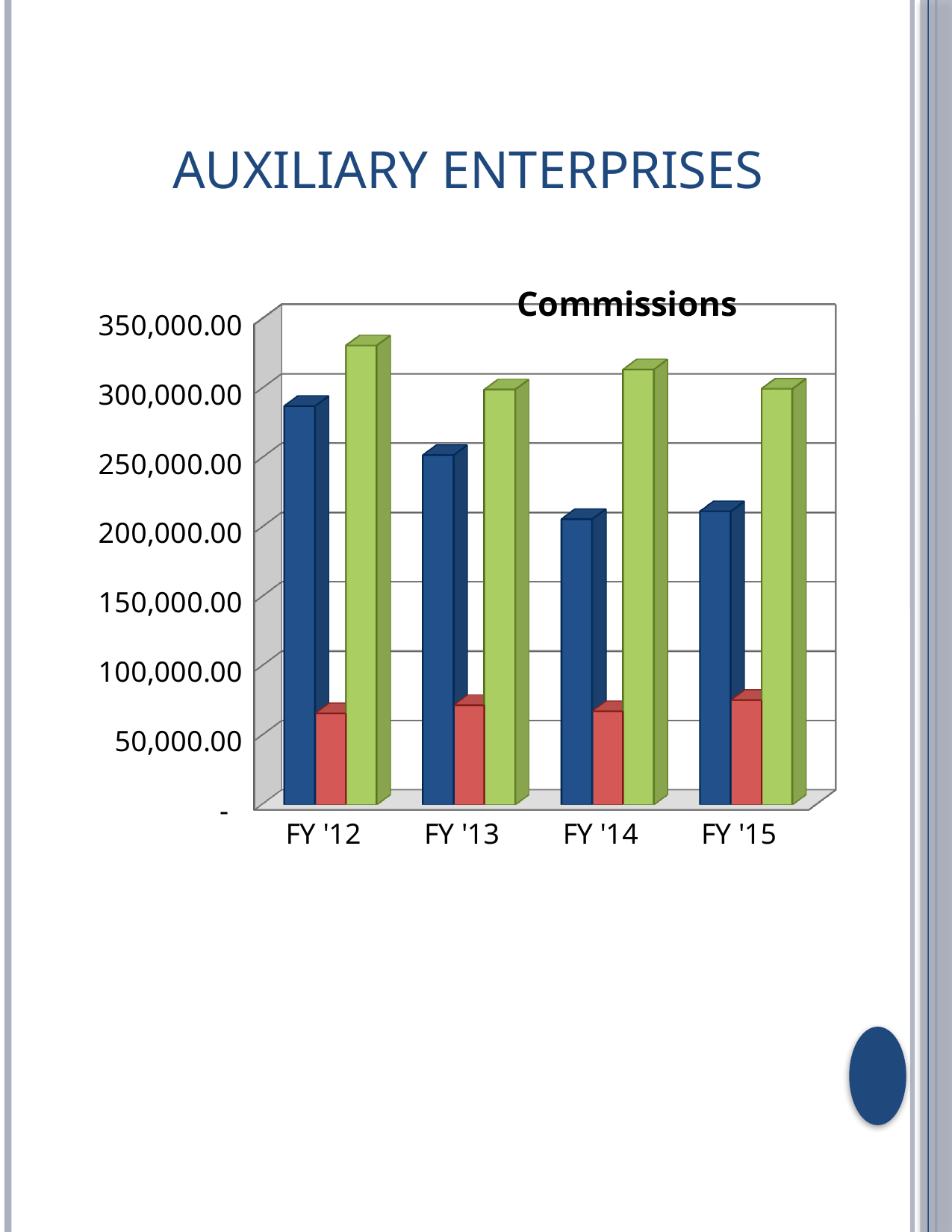
In which fiscal year is the green bar the highest? FY '12 How many fiscal years are shown on the x axis of the chart? 4 In which fiscal year is the blue bar the highest? FY '12 Do the blue bars rise or fall from FY '12 to FY '14? fall How many bars are plotted for each fiscal year in the chart? 3 Is the value of the red bar for FY '15 greater or less than 100,000.00? less Is the value of the blue bar for FY '14 greater or less than 250,000.00? less Is the value of the green bar for FY '12 greater or less than 300,000.00? greater What type of chart is shown on the slide? bar chart Which is larger, the blue bar for FY '12 or the blue bar for FY '15? FY '12 What is the title of the chart? Commissions